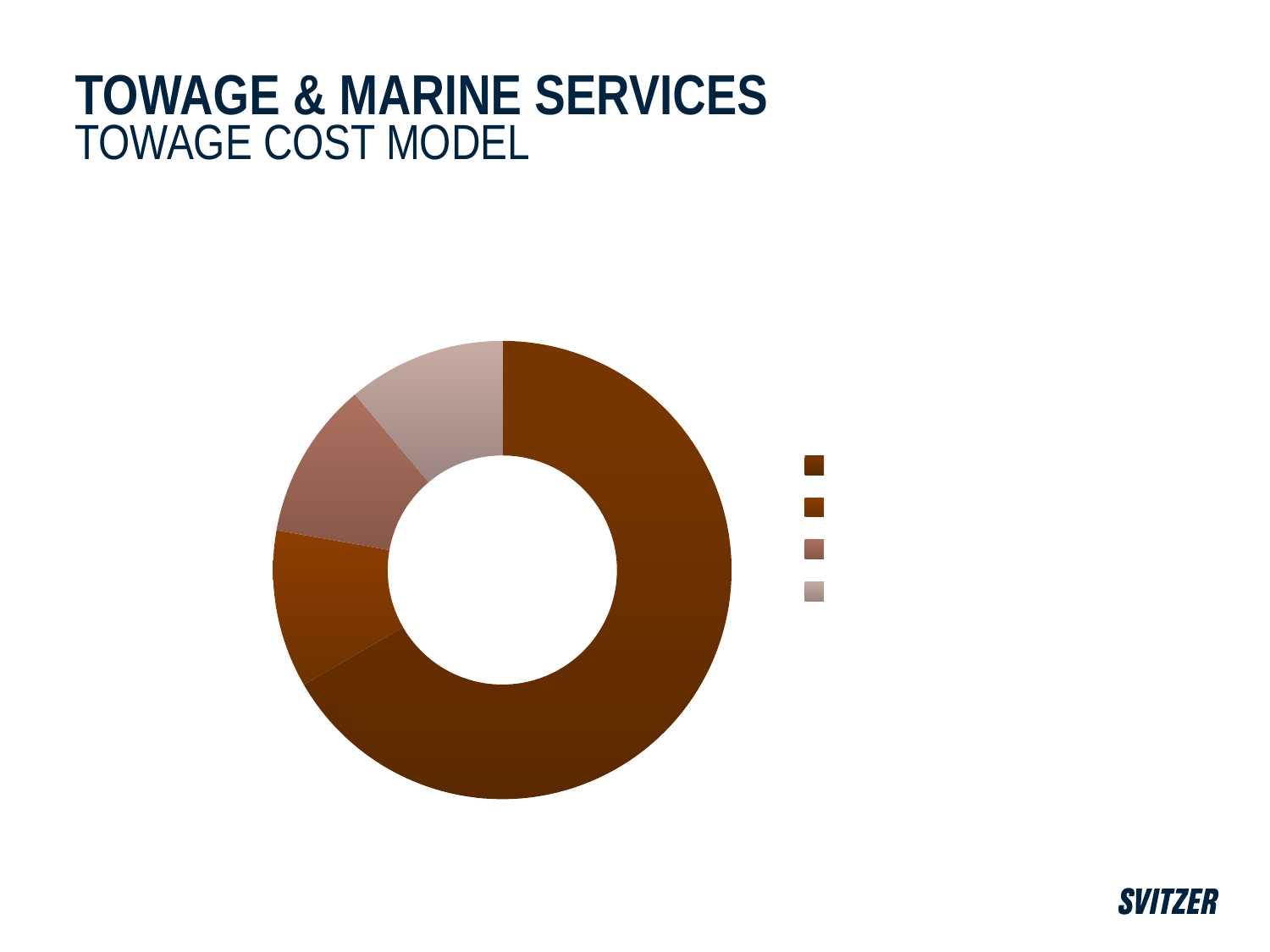
What is the subtitle of the slide above the chart? TOWAGE COST MODEL What kind of chart is shown on the slide? Doughnut (pie) chart Does the largest slice of the doughnut chart account for more or less than half of the whole? More How many entries does the legend to the right of the chart list? 4 Which colour slice is the largest in the doughnut chart? The dark brown slice Are the legend entries next to the chart labelled with readable text? No Is the largest slice of the doughnut chart larger than the other three slices combined? Yes How many slices does the doughnut chart have? 4